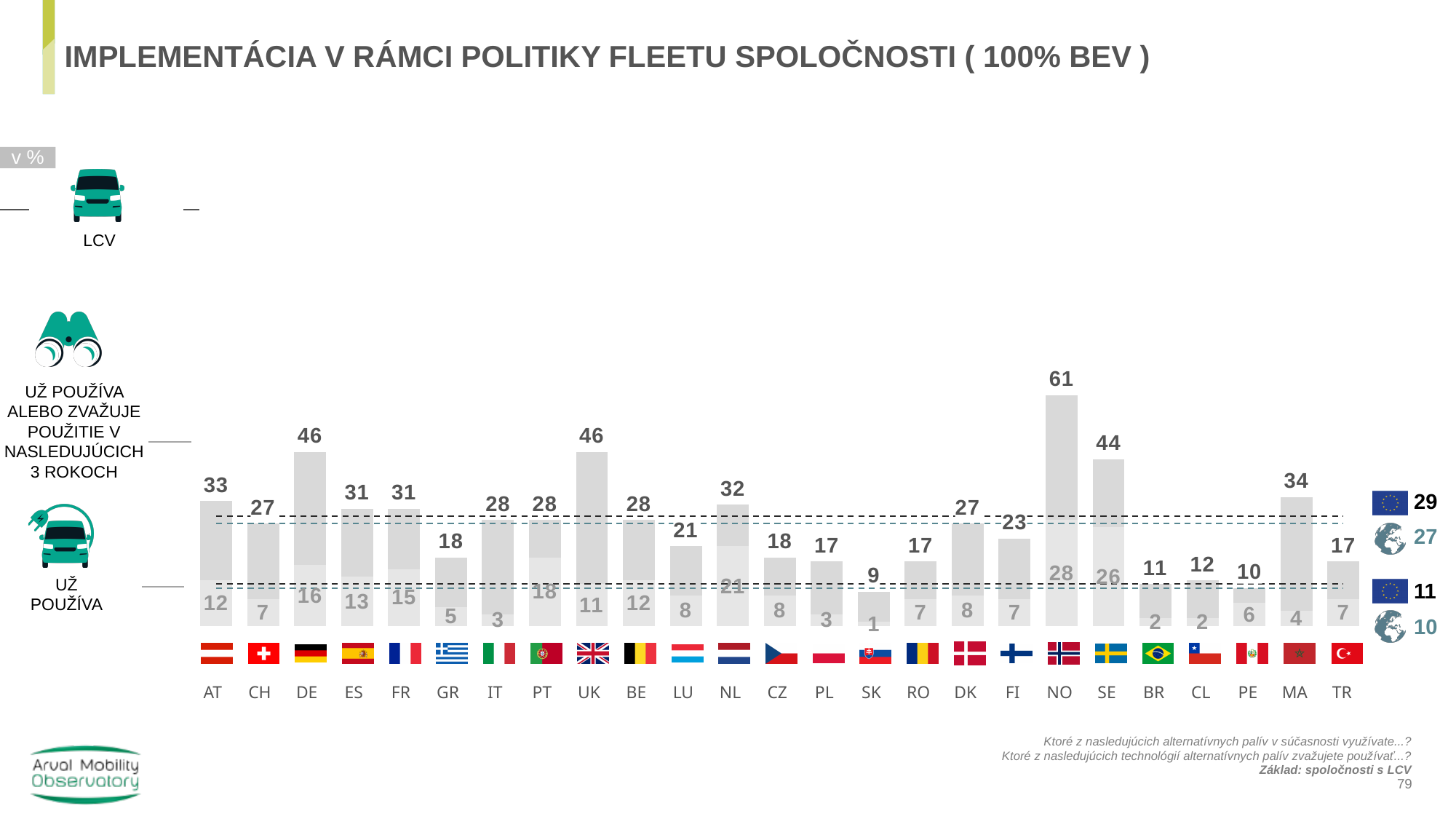
What is the difference between the 'Už používa alebo zvažuje' values for NO and SE? 17 What is the 'Už používa' value for NL? 21 What is the global reference value shown for 'Už používa'? 10 What is the 'Už používa' value for DE? 16 What is the value for NO for 'Už používa alebo zvažuje použitie v nasledujúcich 3 rokoch'? 61 In what unit are the values on the chart expressed? % How many countries are shown on the x axis of the chart? 25 What is the EU reference value shown for 'Už používa alebo zvažuje použitie v nasledujúcich 3 rokoch'? 29 Which country has the highest value for 'Už používa alebo zvažuje použitie v nasledujúcich 3 rokoch'? NO Which country has the lowest 'Už používa' value? SK Which has a higher 'Už používa' value, PT or UK? PT What kind of chart is shown on the slide? Bar chart